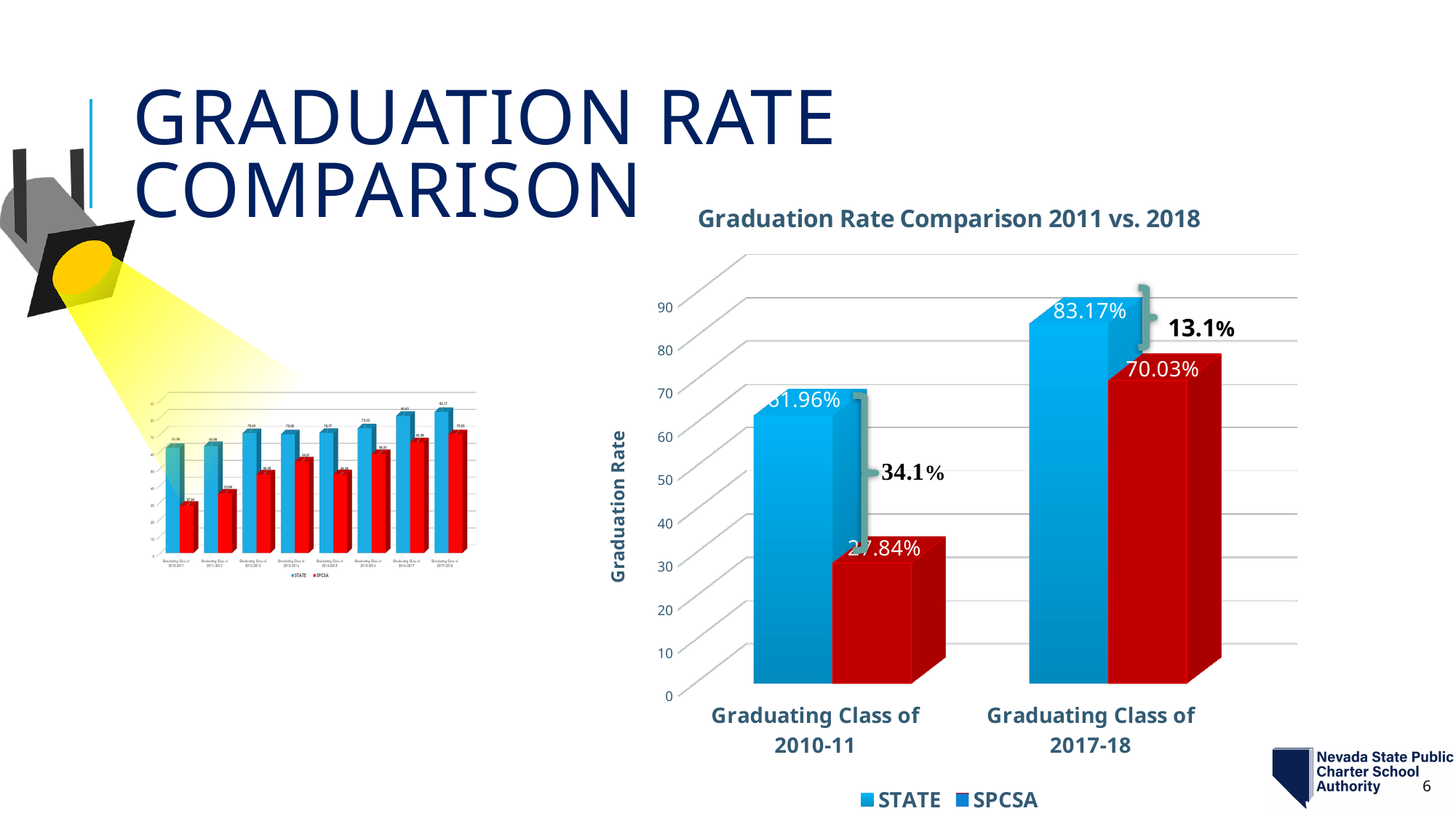
In the chart titled 'Graduation Rate Comparison 2011 vs. 2018', does the SPCSA graduation rate rise or fall from the Graduating Class of 2010-11 to the Graduating Class of 2017-18? rise In the chart titled 'Graduation Rate Comparison 2011 vs. 2018', what is the SPCSA graduation rate for the Graduating Class of 2017-18? 70.03% In the chart titled 'Graduation Rate Comparison 2011 vs. 2018', how many series does the legend list? 2 In the chart titled 'Graduation Rate Comparison 2011 vs. 2018', is the SPCSA value for the Graduating Class of 2010-11 greater or less than 30? less In the chart titled 'Graduation Rate Comparison 2011 vs. 2018', which series has the higher value for the Graduating Class of 2017-18, STATE or SPCSA? STATE In the chart titled 'Graduation Rate Comparison 2011 vs. 2018', what gap percentage is printed between the STATE and SPCSA bars for the Graduating Class of 2010-11? 34.1% What kind of chart is the one titled 'Graduation Rate Comparison 2011 vs. 2018'? bar chart In the chart titled 'Graduation Rate Comparison 2011 vs. 2018', what gap percentage is printed between the STATE and SPCSA bars for the Graduating Class of 2017-18? 13.1% In the chart titled 'Graduation Rate Comparison 2011 vs. 2018', is the STATE value for the Graduating Class of 2010-11 greater or less than 60? greater In the chart titled 'Graduation Rate Comparison 2011 vs. 2018', which bar is the lowest? SPCSA, Graduating Class of 2010-11 In the chart titled 'Graduation Rate Comparison 2011 vs. 2018', which bar is the highest? STATE, Graduating Class of 2017-18 In the chart titled 'Graduation Rate Comparison 2011 vs. 2018', what is the STATE graduation rate for the Graduating Class of 2017-18? 83.17%